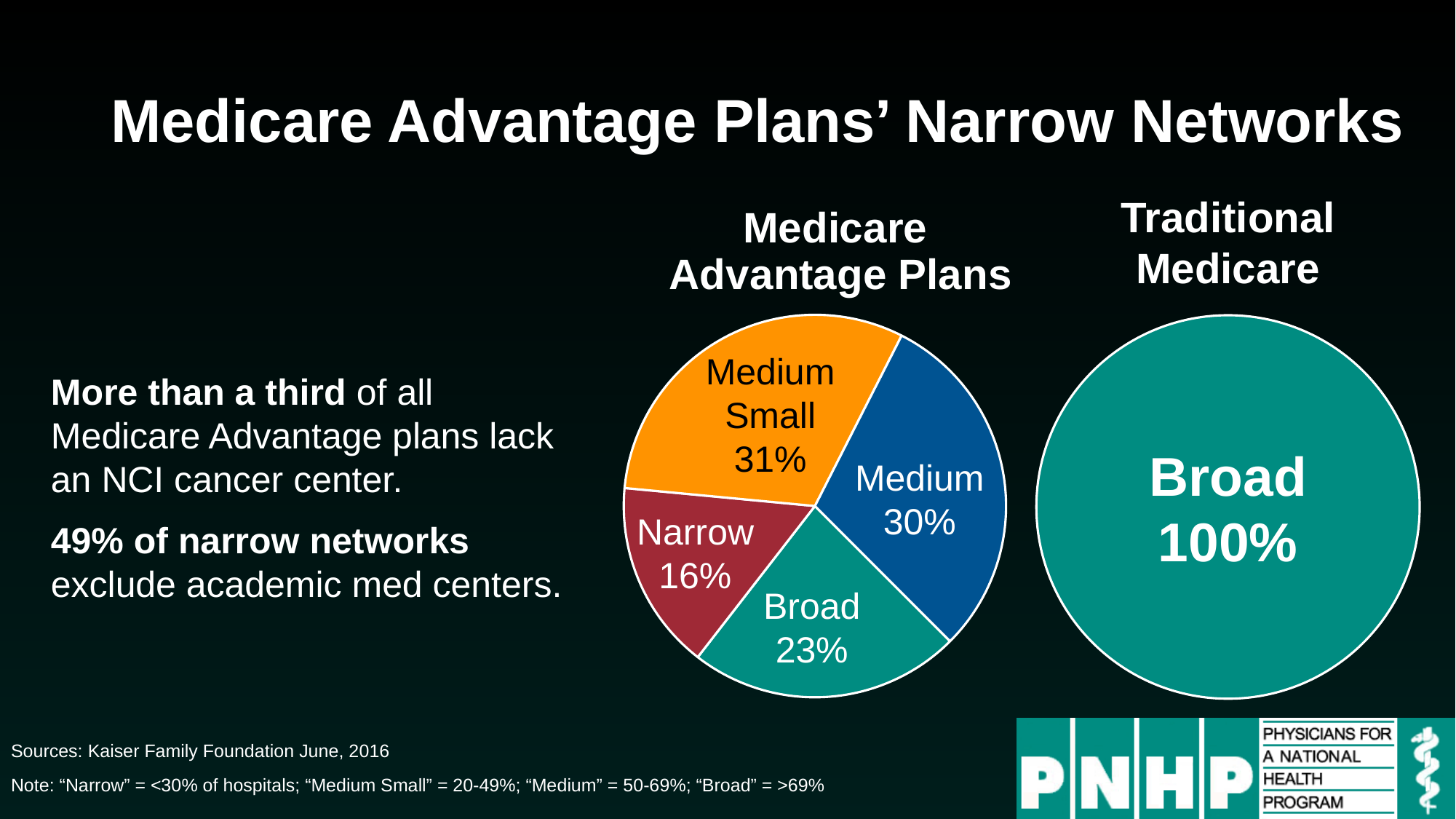
What kind of chart is the Medicare Advantage Plans chart? Pie chart In the Medicare Advantage Plans chart, what share of plans have a Narrow network? 16% In the Traditional Medicare chart, what share is labelled Broad? 100% In the Medicare Advantage Plans chart, which is larger, the Broad share or the Medium share? Medium How many categories does the Medicare Advantage Plans chart show? 4 In the Medicare Advantage Plans chart, what share of plans have a Medium Small network? 31% In the Medicare Advantage Plans chart, which network category has the largest share? Medium Small In the Medicare Advantage Plans chart, which network category has the smallest share? Narrow In the Medicare Advantage Plans chart, what colour is the Narrow slice? Dark red In the Medicare Advantage Plans chart, what share of plans have a Medium network? 30% In the Medicare Advantage Plans chart, what is the difference between the Medium Small share and the Narrow share? 15% In the Medicare Advantage Plans chart, what share of plans have a Broad network? 23%